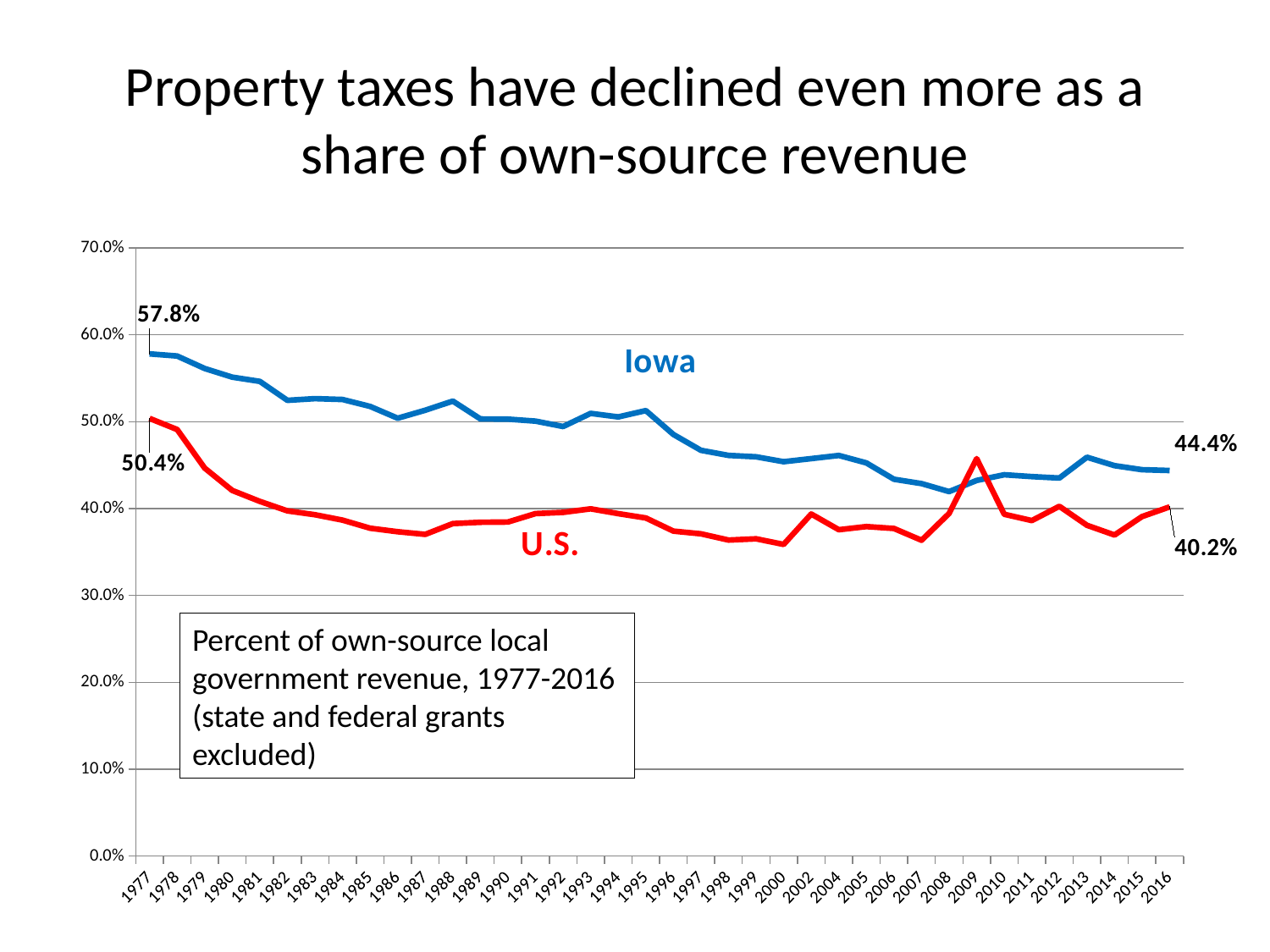
Is the U.S. value for 1987 greater or less than 40%? less By how many percentage points did Iowa's share fall from 1977 to 2016? 13.4 percentage points What was Iowa's property tax share of own-source revenue in 1977? 57.8% What kind of chart is shown on the slide? line chart What was the U.S. property tax share of own-source revenue in 1977? 50.4% By how many percentage points did the U.S. share fall from 1977 to 2016? 10.2 percentage points What was Iowa's property tax share of own-source revenue in 2016? 44.4% In 2016, how many percentage points higher was Iowa's share than the U.S. share? 4.2 percentage points How many lines (series) are plotted on the chart? 2 Does the Iowa line generally rise or fall from 1977 to 2016? fall What was the U.S. property tax share of own-source revenue in 2016? 40.2% In 1977, which had the higher property tax share of own-source revenue, Iowa or the U.S.? Iowa